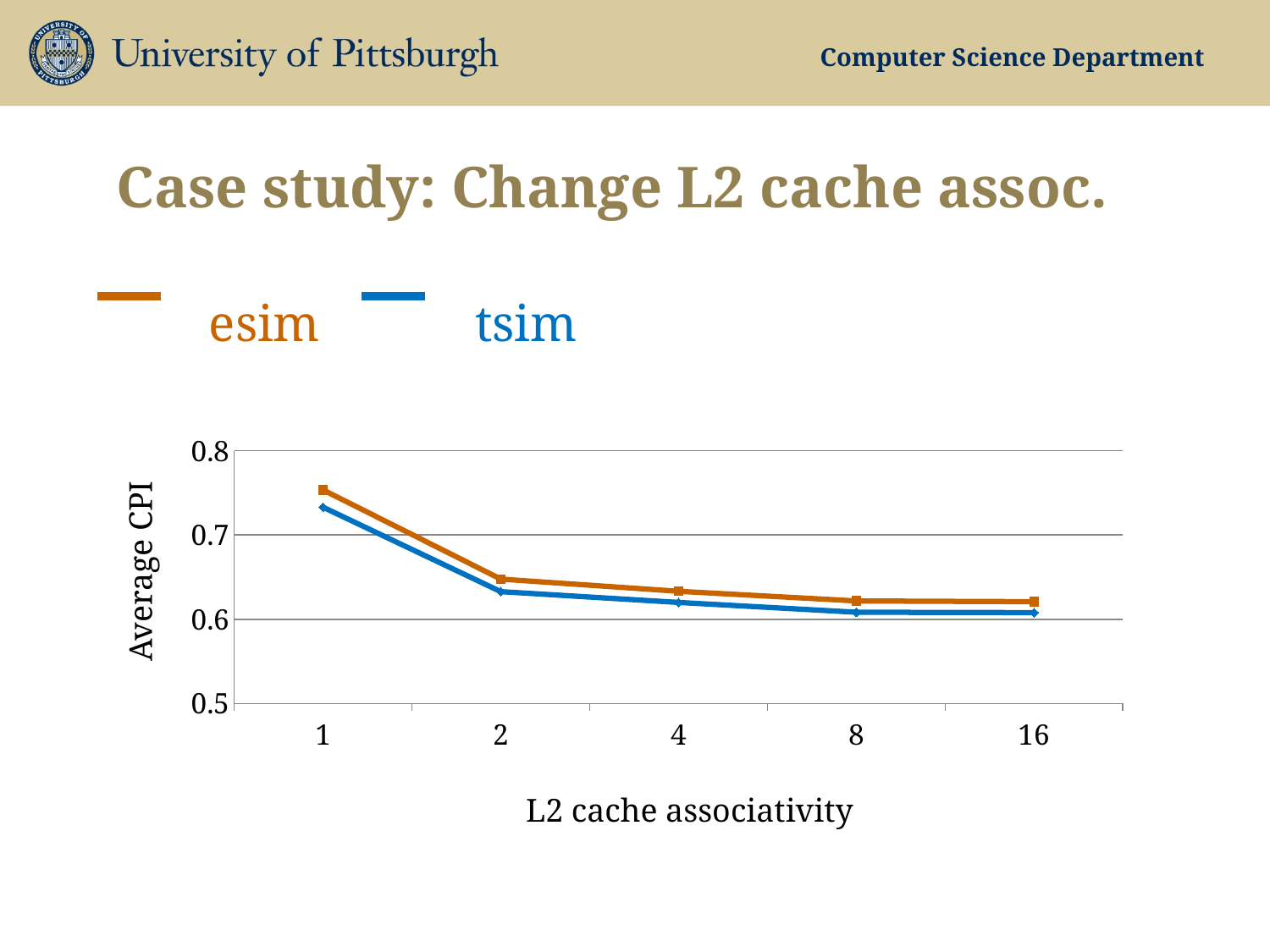
At L2 cache associativity 1, which series has the higher Average CPI, esim or tsim? esim Is the Average CPI for tsim at L2 cache associativity 4 greater or less than 0.7? less At L2 cache associativity 2, which series has the higher Average CPI, esim or tsim? esim What kind of chart is shown on the slide? line chart At which L2 cache associativity is the Average CPI for tsim highest? 1 What is the label of the y axis? Average CPI At which L2 cache associativity is the Average CPI for esim highest? 1 Is the Average CPI for esim at L2 cache associativity 1 greater or less than 0.7? greater How many L2 cache associativity values are plotted along the x axis? 5 How many series does the legend list? 2 Does the Average CPI for esim rise or fall as L2 cache associativity increases? fall Which colour is used for the tsim series? blue